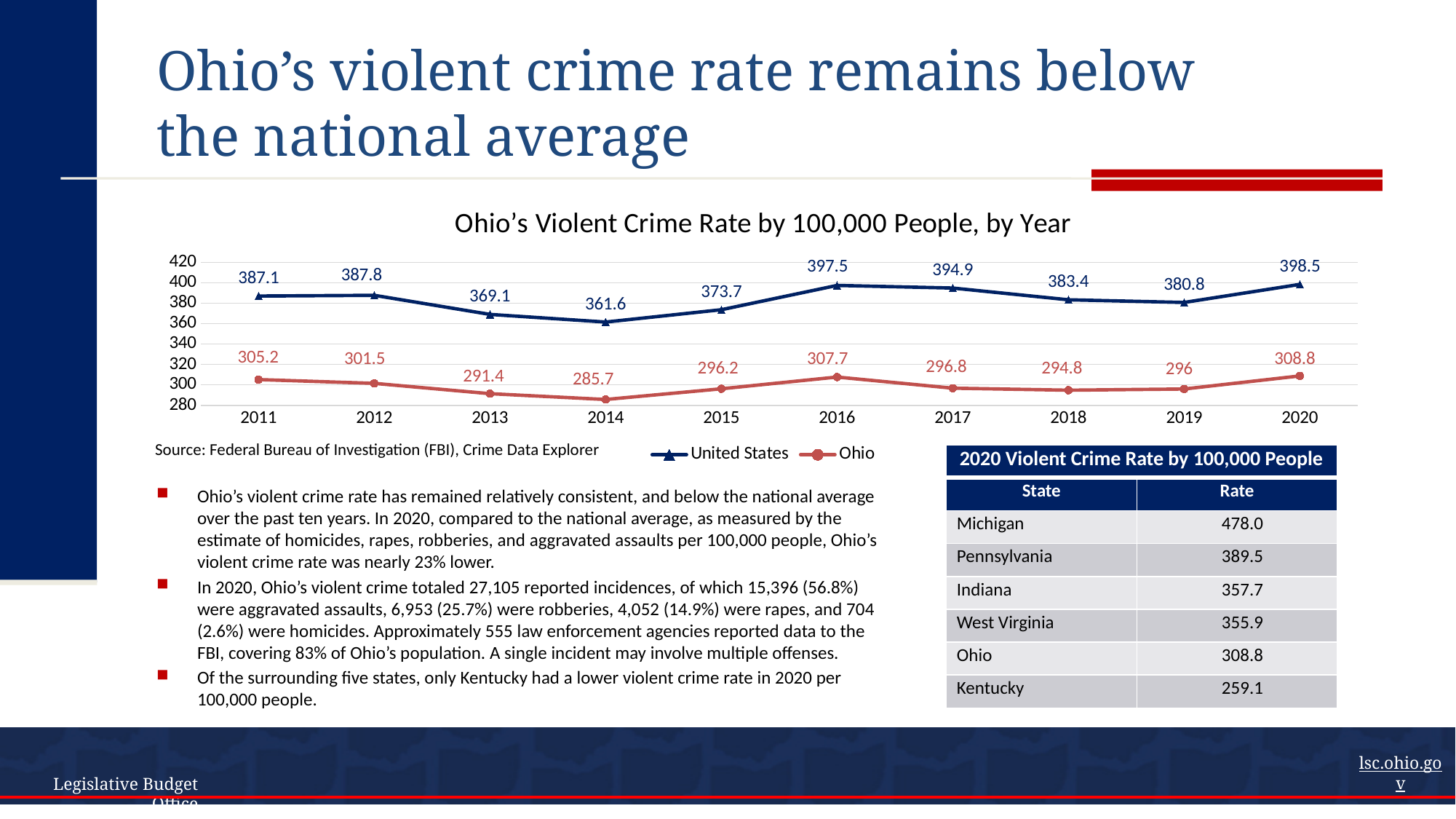
Is the United States value for 2014 greater or less than 380? less In which year is the United States violent crime rate the highest? 2020 How many years are shown on the x axis of the chart? 10 What is the title of the chart? Ohio's Violent Crime Rate by 100,000 People, by Year How many series does the chart legend list? 2 Which year has the higher Ohio violent crime rate, 2012 or 2013? 2012 In which year is Ohio's violent crime rate the lowest? 2014 Does Ohio's violent crime rate rise or fall from 2011 to 2014? fall What is Ohio's violent crime rate in 2014? 285.7 What kind of chart is shown on the slide? line chart What is the United States violent crime rate in 2016? 397.5 What is the difference between the United States and Ohio violent crime rates in 2020? 89.7